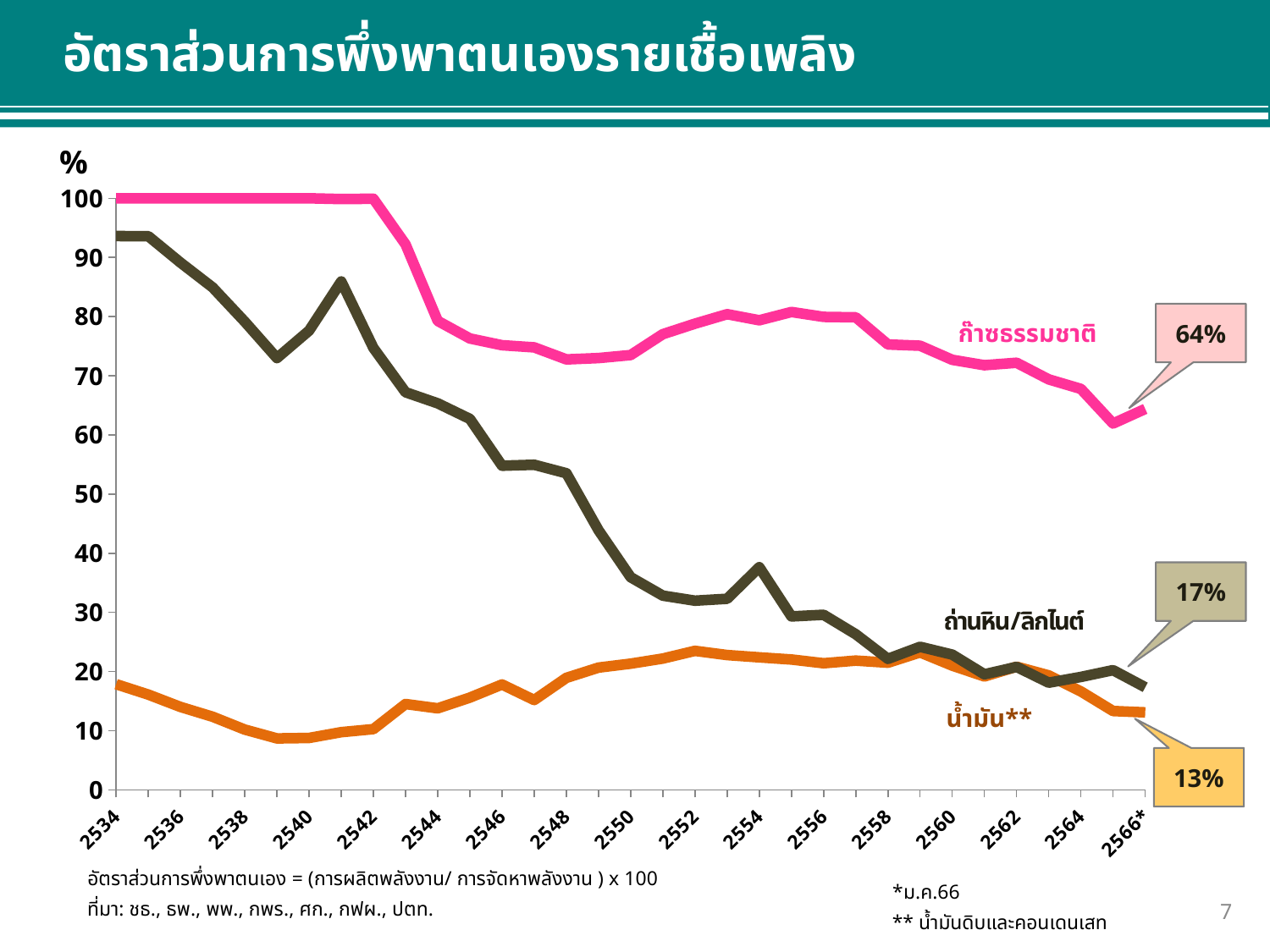
Does the ก๊าซธรรมชาติ line rise or fall overall from 2534 to 2566*? fall At 2566*, which is larger: ถ่านหิน/ลิกไนต์ or น้ำมัน**? ถ่านหิน/ลิกไนต์ Which fuel has the highest self-sufficiency ratio at 2566*? ก๊าซธรรมชาติ What is the value for ก๊าซธรรมชาติ (natural gas) at 2566*? 64% How many fuel series are plotted on the chart? 3 What kind of chart is shown on the slide? line chart At 2566*, how many percentage points higher is ก๊าซธรรมชาติ than ถ่านหิน/ลิกไนต์? 47 Which fuel has the lowest self-sufficiency ratio at 2566*? น้ำมัน** What is the value for ถ่านหิน/ลิกไนต์ (coal/lignite) at 2566*? 17% Is the value for ถ่านหิน/ลิกไนต์ at 2550 greater or less than 40? less At 2566*, what is the difference between ถ่านหิน/ลิกไนต์ and น้ำมัน**? 4 percentage points What is the value for น้ำมัน** (oil) at 2566*? 13%